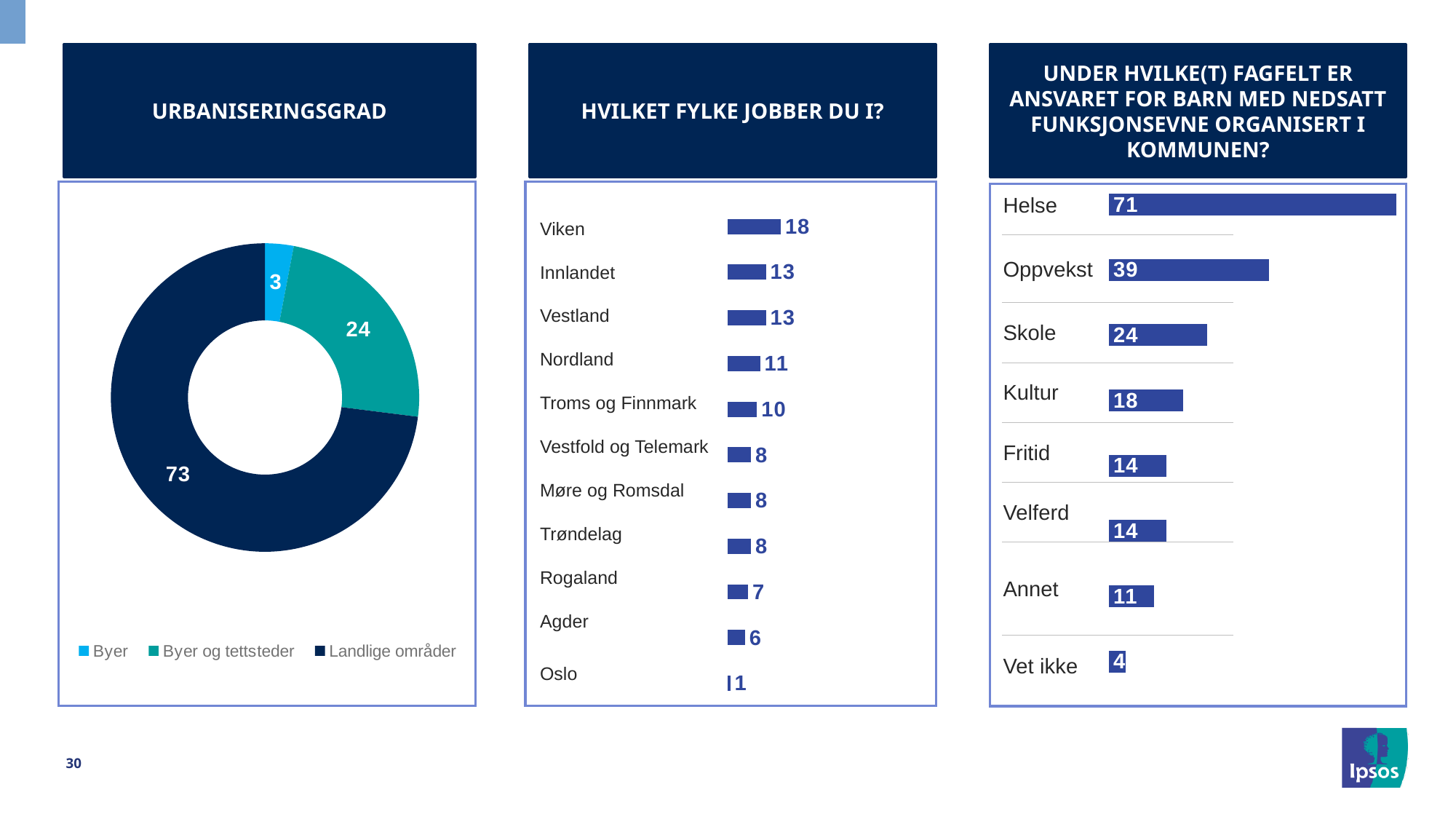
In the 'HVILKET FYLKE JOBBER DU I?' chart, what is the difference between Viken and Oslo? 17 In the 'HVILKET FYLKE JOBBER DU I?' chart, how many fylker are listed? 11 In the 'HVILKET FYLKE JOBBER DU I?' chart, what is the value for Nordland? 11 In the chart 'UNDER HVILKE(T) FAGFELT ER ANSVARET FOR BARN MED NEDSATT FUNKSJONSEVNE ORGANISERT I KOMMUNEN?', which category has the highest value? Helse In the 'URBANISERINGSGRAD' chart, how many categories does the legend list? 3 In the chart 'UNDER HVILKE(T) FAGFELT ER ANSVARET FOR BARN MED NEDSATT FUNKSJONSEVNE ORGANISERT I KOMMUNEN?', which is larger, Skole or Kultur? Skole What kind of chart is the 'URBANISERINGSGRAD' chart? Donut (pie) chart In the 'URBANISERINGSGRAD' chart, what is the value for Landlige områder? 73 In the 'HVILKET FYLKE JOBBER DU I?' chart, which fylke has the highest value? Viken In the chart 'UNDER HVILKE(T) FAGFELT ER ANSVARET FOR BARN MED NEDSATT FUNKSJONSEVNE ORGANISERT I KOMMUNEN?', what is the value for Oppvekst? 39 In the 'URBANISERINGSGRAD' chart, which category has the smallest value? Byer What kind of chart is the 'HVILKET FYLKE JOBBER DU I?' chart? Bar chart